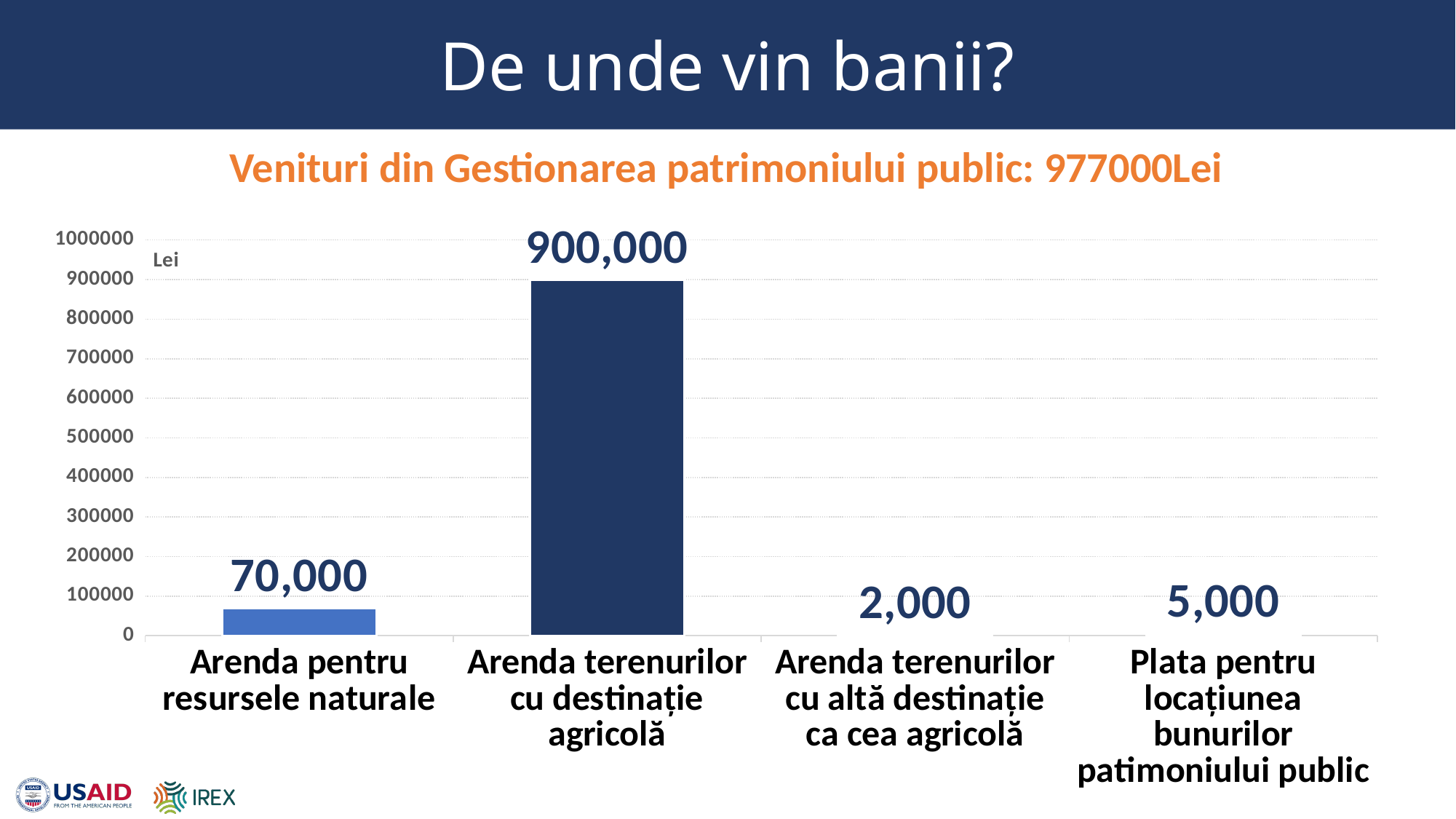
What is the value for Arenda pentru resursele naturale? 70,000 What is the chart's title? Venituri din Gestionarea patrimoniului public: 977000Lei What is the value for Arenda terenurilor cu altă destinație ca cea agricolă? 2,000 What kind of chart is shown on the slide? bar chart Which category has the lowest value? Arenda terenurilor cu altă destinație ca cea agricolă What is the value for Arenda terenurilor cu destinație agricolă? 900,000 How many categories are shown in the chart? 4 What is the difference between the values for Arenda terenurilor cu destinație agricolă and Arenda pentru resursele naturale? 830,000 What is the value for Plata pentru locațiunea bunurilor patrimoniului public? 5,000 Which category has the highest value? Arenda terenurilor cu destinație agricolă Which is larger: the value for Plata pentru locațiunea bunurilor patrimoniului public or the value for Arenda terenurilor cu altă destinație ca cea agricolă? Plata pentru locațiunea bunurilor patrimoniului public Is the value for Arenda pentru resursele naturale greater or less than 100000? less